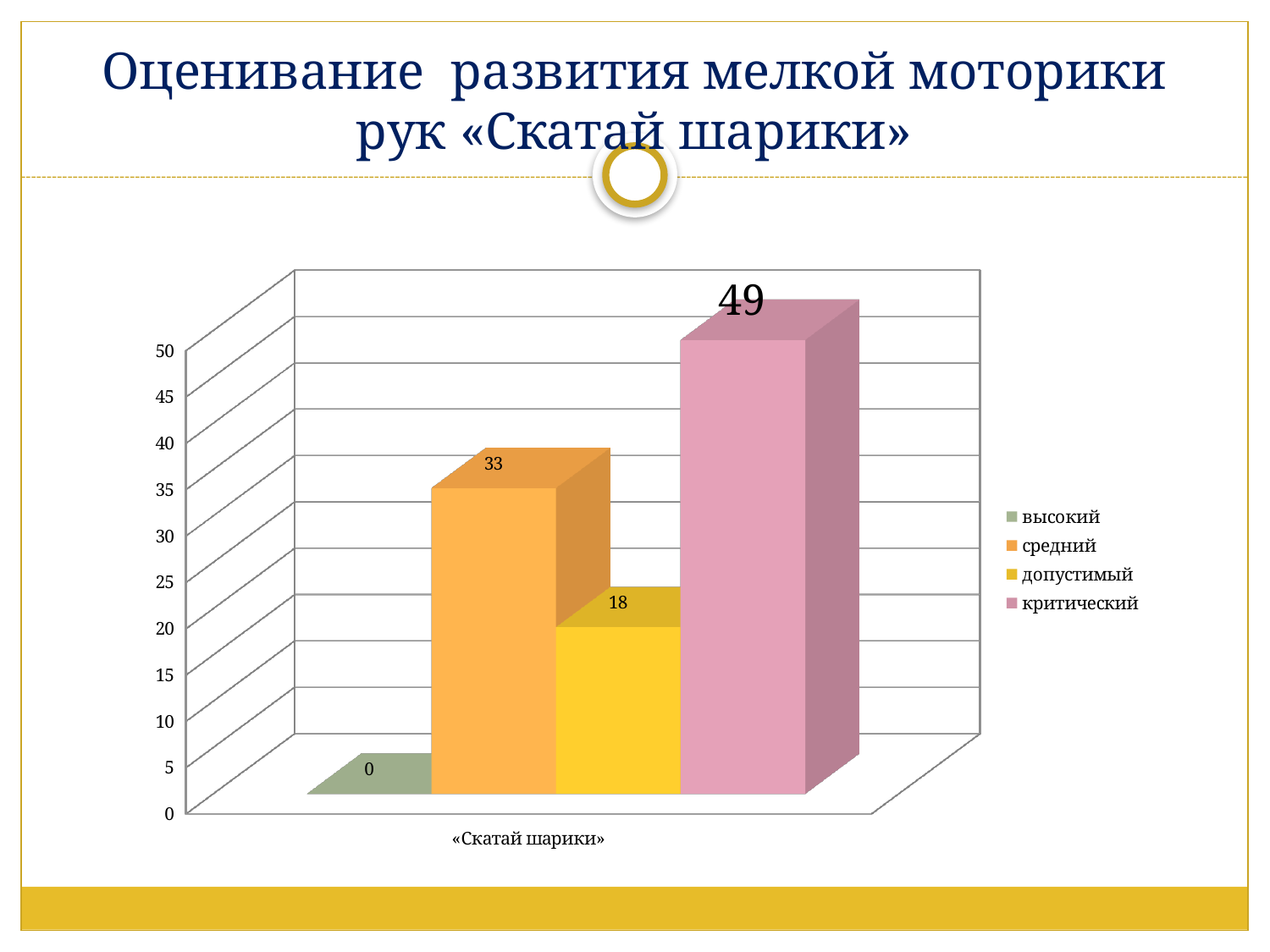
What is the value for «допустимый» in the chart? 18 How many series does the legend list? 4 What is the difference between the values for «средний» and «допустимый»? 15 Which is larger, the value for «допустимый» or the value for «средний»? средний Which series has the lowest value in the chart? высокий Which series has the highest value in the chart? критический What is the category label shown on the x axis of the chart? «Скатай шарики» What is the value for «критический» in the chart? 49 What is the value for «высокий» in the chart? 0 What is the value for «средний» in the chart? 33 What is the difference between the values for «критический» and «средний»? 16 What kind of chart is shown on the slide? bar chart